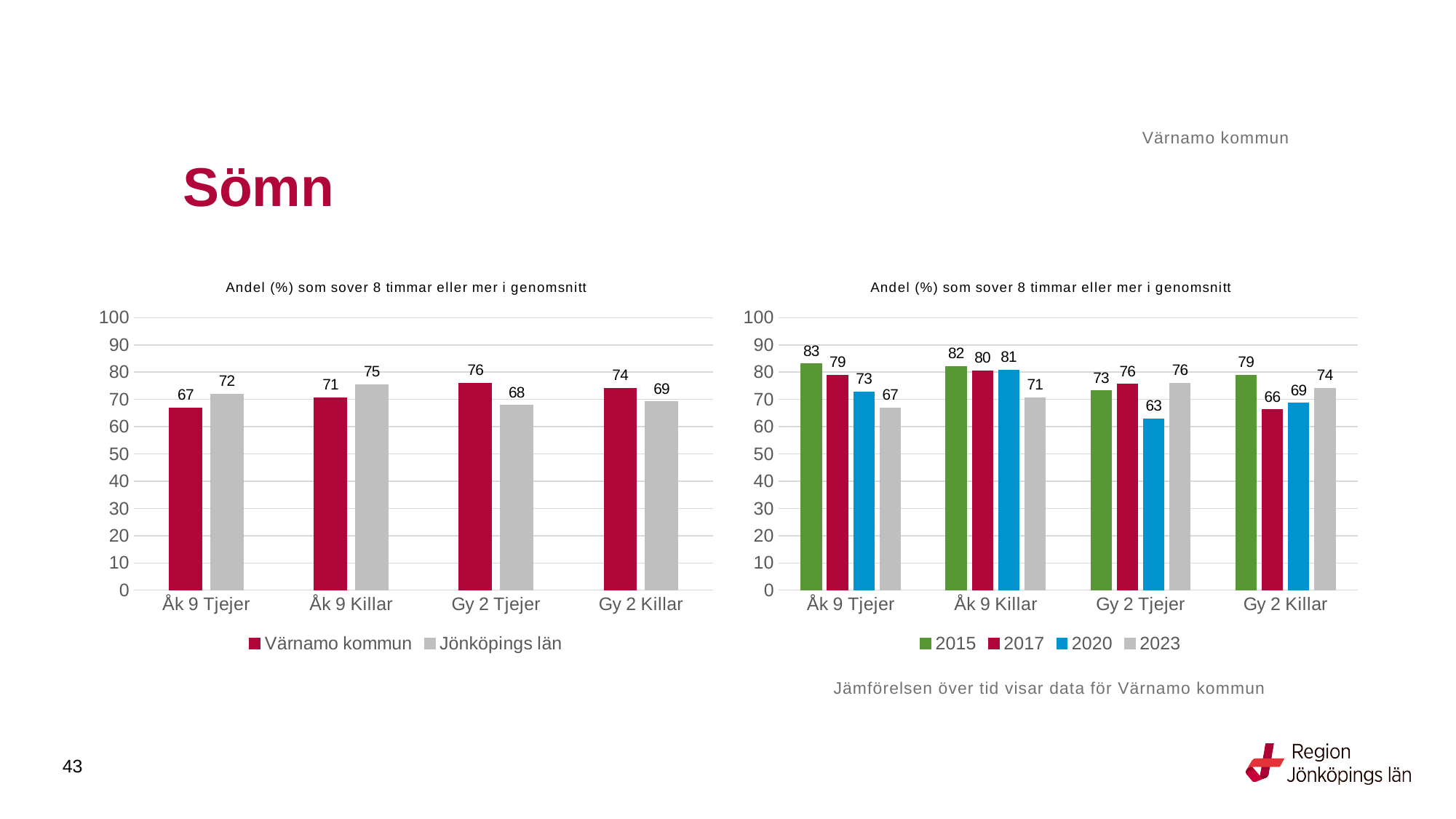
In the left chart, which category has the highest value for Värnamo kommun? Gy 2 Tjejer In the right chart, how many series does the legend list? 4 In the right chart, what is the difference between 2015 and 2023 for Åk 9 Tjejer? 16 In the right chart, what is the value for 2015 for Åk 9 Tjejer? 83 In the left chart, what is the difference between Jönköpings län and Värnamo kommun for Åk 9 Tjejer? 5 In the left chart, which is larger for Gy 2 Killar: Värnamo kommun or Jönköpings län? Värnamo kommun In the right chart, what is the value for 2020 for Gy 2 Tjejer? 63 What kind of chart is the right chart? Bar chart In the left chart, what is the value for Jönköpings län for Gy 2 Tjejer? 68 In the left chart, how many series does the legend list? 2 In the right chart, which category has the lowest value for 2017? Gy 2 Killar In the left chart, what is the value for Värnamo kommun for Åk 9 Tjejer? 67